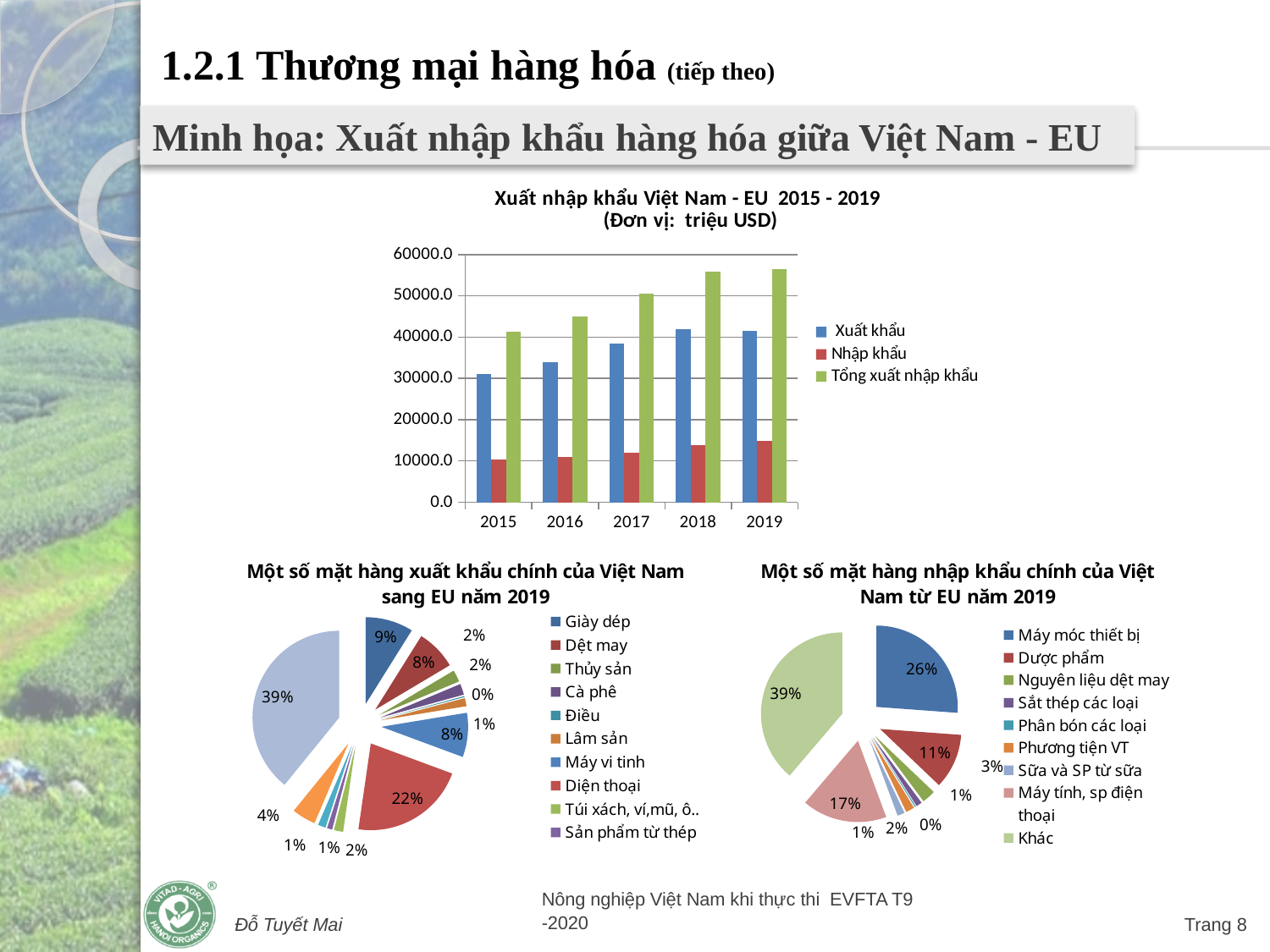
In the bottom-left pie chart 'Một số mặt hàng xuất khẩu chính của Việt Nam sang EU năm 2019', what share does Điện thoại have? 22% In the top chart 'Xuất nhập khẩu Việt Nam - EU 2015 - 2019', which series has the tallest bar in every year? Tổng xuất nhập khẩu What kind of chart is the top chart titled 'Xuất nhập khẩu Việt Nam - EU 2015 - 2019'? bar chart In the bottom-right pie chart 'Một số mặt hàng nhập khẩu chính của Việt Nam từ EU năm 2019', what share does Khác have? 39% How many series does the legend of the top chart 'Xuất nhập khẩu Việt Nam - EU 2015 - 2019' list? 3 In the bottom-right pie chart 'Một số mặt hàng nhập khẩu chính của Việt Nam từ EU năm 2019', what share does Máy móc thiết bị have? 26% In the bottom-right pie chart 'Một số mặt hàng nhập khẩu chính của Việt Nam từ EU năm 2019', which is larger: Dược phẩm or Máy tính, sp điện thoại? Máy tính, sp điện thoại In the bottom-left pie chart 'Một số mặt hàng xuất khẩu chính của Việt Nam sang EU năm 2019', what is the largest percentage shown on any slice? 39% In the top chart 'Xuất nhập khẩu Việt Nam - EU 2015 - 2019', is the Tổng xuất nhập khẩu value for 2019 greater or less than 50000.0? greater How many years are shown on the x axis of the top chart 'Xuất nhập khẩu Việt Nam - EU 2015 - 2019'? 5 In the top chart 'Xuất nhập khẩu Việt Nam - EU 2015 - 2019', does the Tổng xuất nhập khẩu series rise or fall from 2015 to 2019? rise In the top chart 'Xuất nhập khẩu Việt Nam - EU 2015 - 2019', is the Nhập khẩu value for 2019 greater or less than 20000.0? less